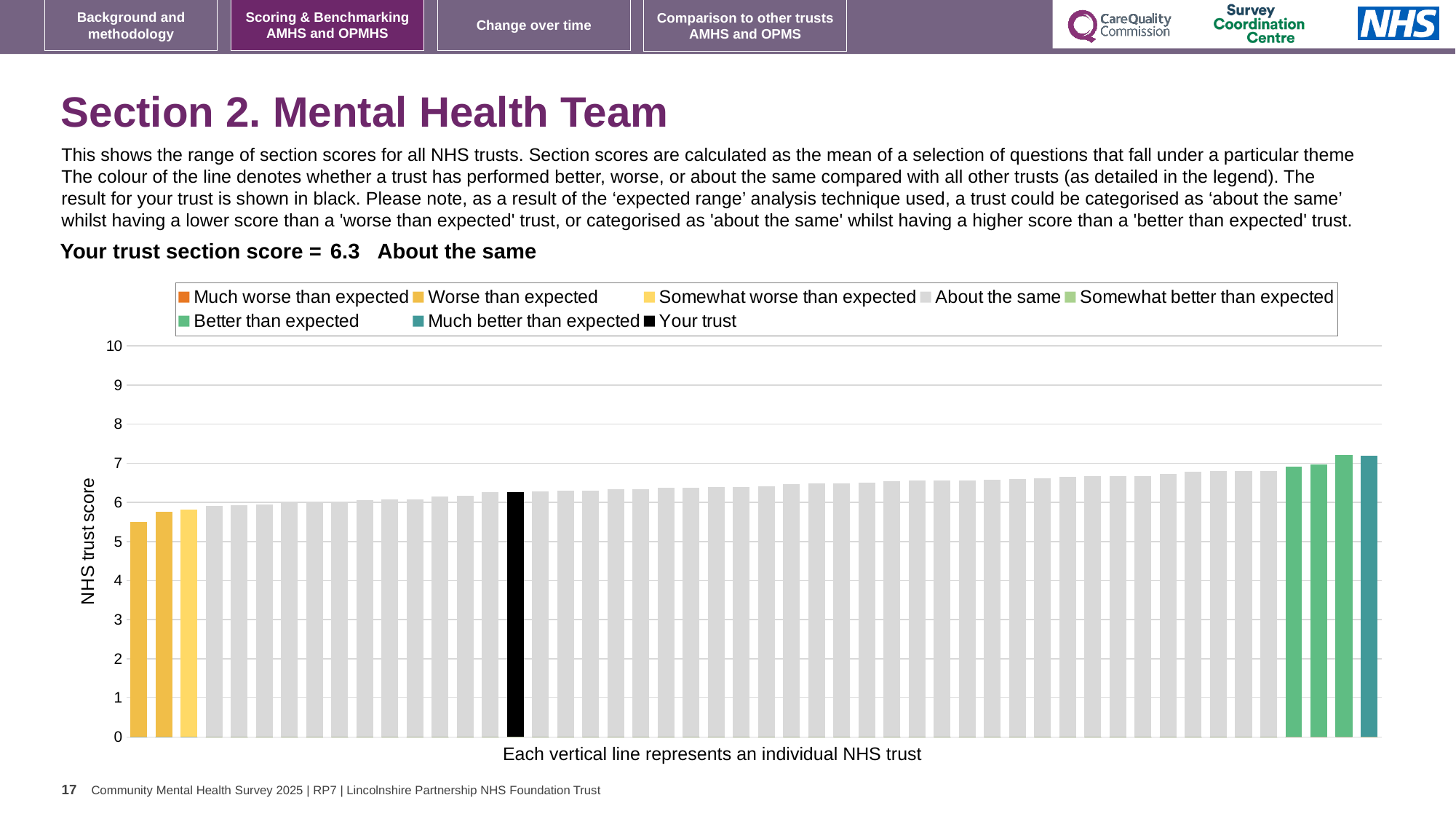
Which is taller, the leftmost bar or the rightmost bar? rightmost Is the value of the leftmost bar greater or less than 6? less What is the label on the vertical axis of the chart? NHS trust score What type of chart is shown on the slide? bar chart Do the bar values rise or fall from left to right across the chart? rise What is your trust's section score for Mental Health Team? 6.3 Is the value of the leftmost bar greater or less than 5? greater Is the value of the rightmost bar greater or less than 6? greater According to the slide, which category does your trust's section score fall into? About the same How many entries does the chart legend list? 8